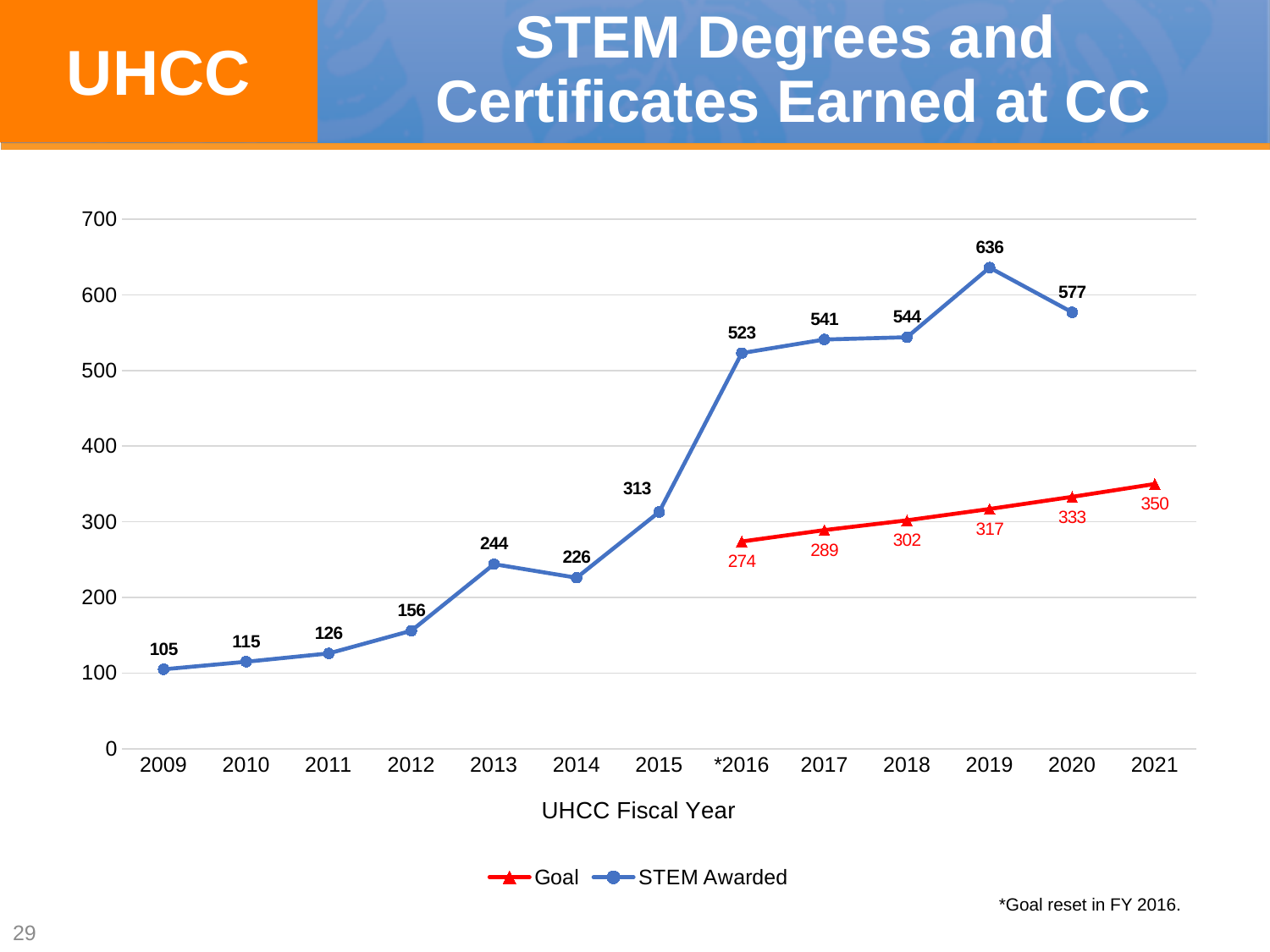
What is the title of the x axis? UHCC Fiscal Year Does the Goal series rise or fall from 2016 to 2021? Rise How many series does the legend list? 2 What is the STEM Awarded value for 2019? 636 What is the STEM Awarded value for 2009? 105 What is the Goal value for 2018? 302 What is the difference between the STEM Awarded value and the Goal value in 2020? 244 Which is larger in 2017, the STEM Awarded value or the Goal value? STEM Awarded Which year has the lowest STEM Awarded value? 2009 How many years are shown on the x axis? 13 Which year has the highest STEM Awarded value? 2019 What kind of chart is shown on the slide? Line chart